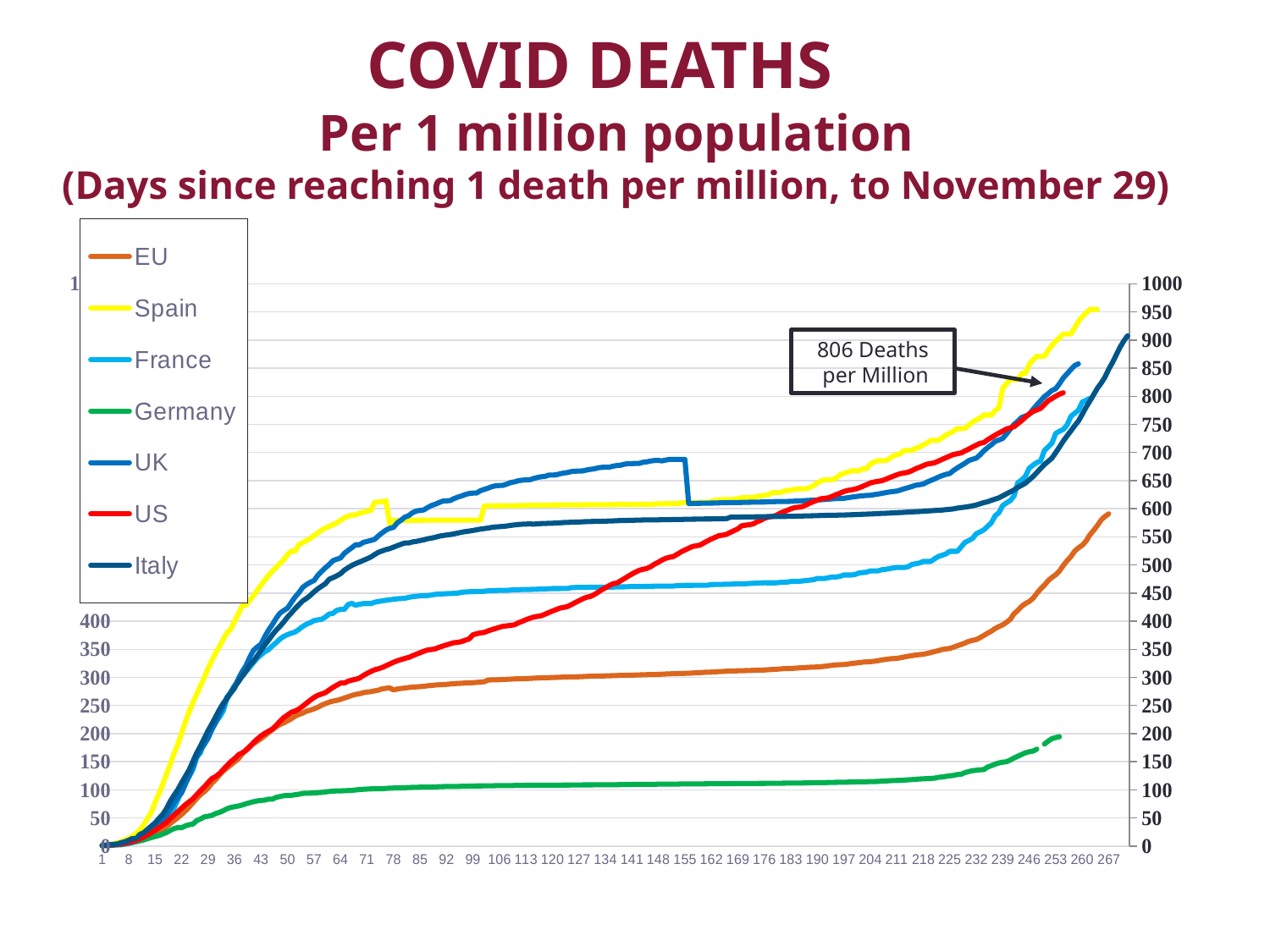
Is the final value for Germany greater or less than 250? less Is the final value for EU greater or less than 500? greater How many series does the legend list? 7 What value does the annotation box on the chart state? 806 Deaths per Million Is the final value for Spain greater or less than 900? greater Do the plotted values generally rise or fall along the x axis? rise At the right end of the chart, which is larger: the value for EU or the value for Germany? EU Around day 150, which is larger: the value for UK or the value for France? UK Which series reaches the highest value at the right end of the chart? Spain Which series has the lowest values across the chart? Germany What kind of chart is shown on the slide? line chart